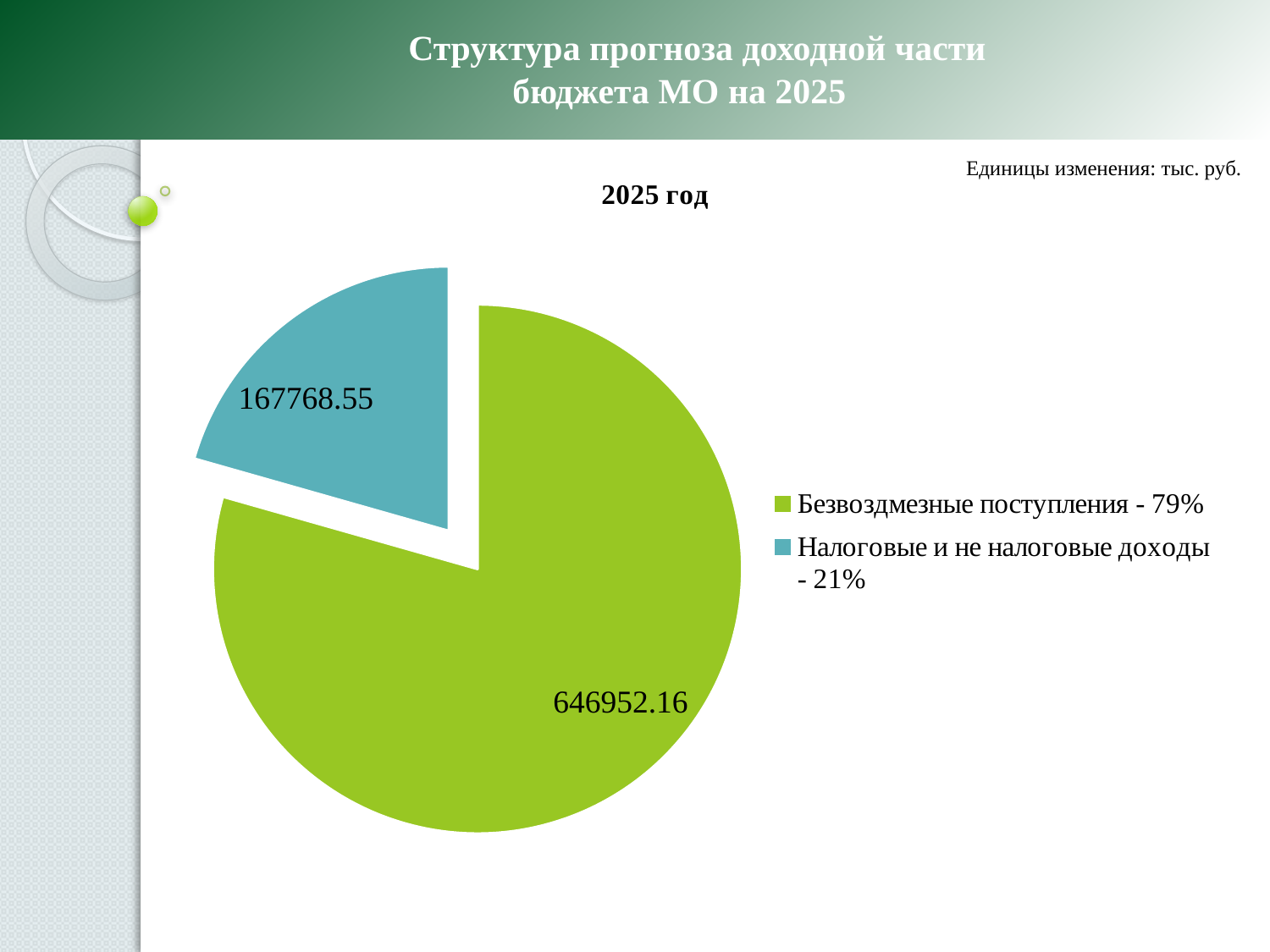
What share of the pie does "Безвоздмезные поступления" represent? 79% What is the title of the pie chart? 2025 год What type of chart is shown on the slide? Pie chart What is the value for "Безвоздмезные поступления" in the pie chart? 646952.16 What is the difference between the values for "Безвоздмезные поступления" and "Налоговые и не налоговые доходы"? 479183.61 How many slices does the pie chart have? 2 Which category has the smallest slice in the pie chart? Налоговые и не налоговые доходы What is the value for "Налоговые и не налоговые доходы" in the pie chart? 167768.55 What is the total of the two values shown in the pie chart? 814720.71 Which is larger: the value for "Безвоздмезные поступления" or for "Налоговые и не налоговые доходы"? Безвоздмезные поступления Which category has the largest slice in the pie chart? Безвоздмезные поступления What share of the pie does "Налоговые и не налоговые доходы" represent? 21%